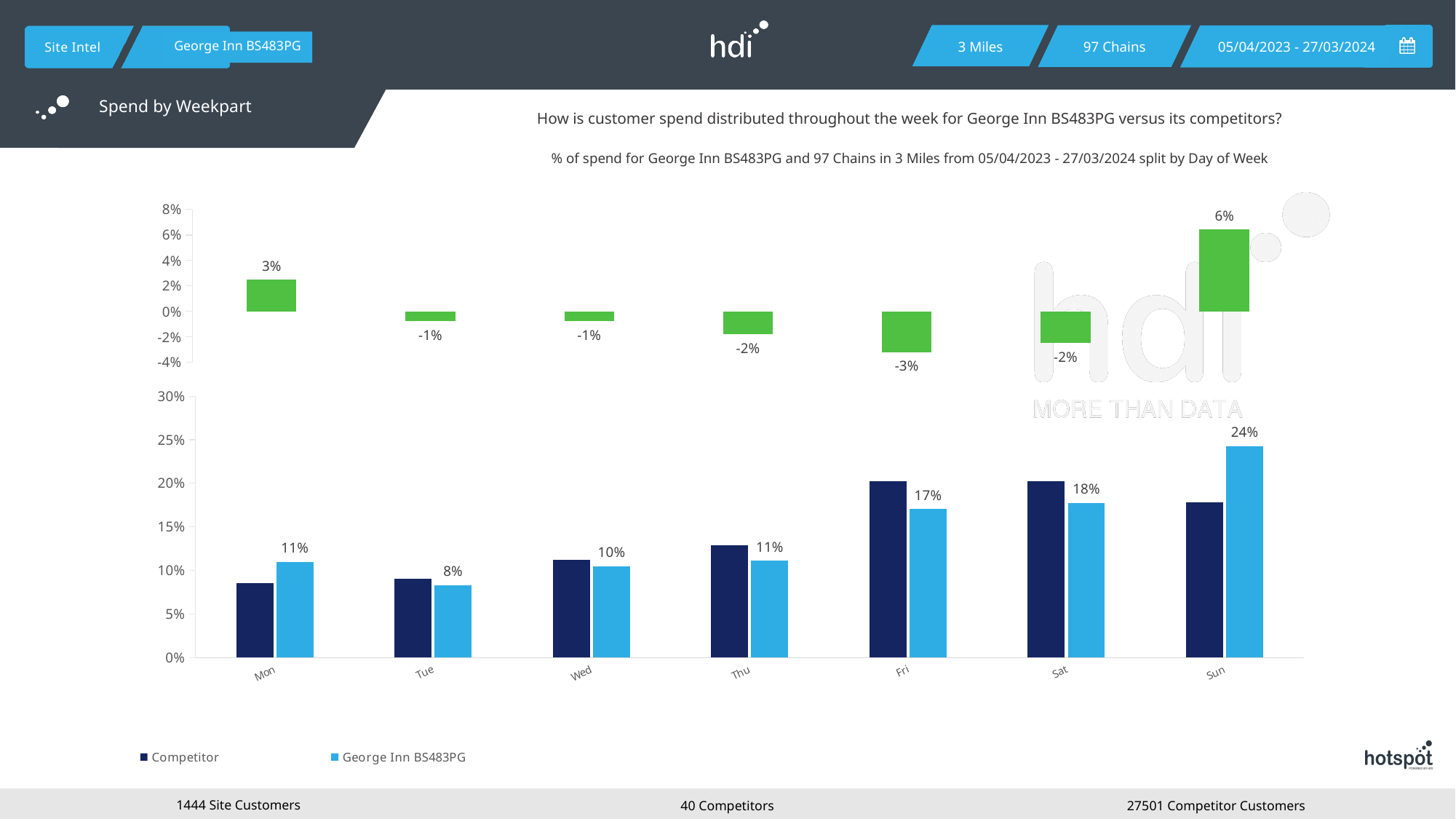
In the bottom chart, what is the value for George Inn BS483PG on Tue? 8% In the bottom chart, is the Competitor value for Mon greater or less than 10%? less In the top chart, which day has the highest value? Sun How many days of the week are shown on the x axis of the bottom chart? 7 In the bottom chart, is the Competitor value for Fri greater or less than 15%? greater In the bottom chart, what is the value for George Inn BS483PG on Sun? 24% In the bottom chart, what is the difference between the George Inn BS483PG values for Sun and Sat? 6% In the top chart, what is the value shown for Fri? -3% In the bottom chart, on Sun, which is larger: the Competitor bar or the George Inn BS483PG bar? George Inn BS483PG How many series does the legend of the bottom chart list? 2 In the bottom chart, which day has the lowest value for George Inn BS483PG? Tue In the bottom chart, which day has the highest value for George Inn BS483PG? Sun